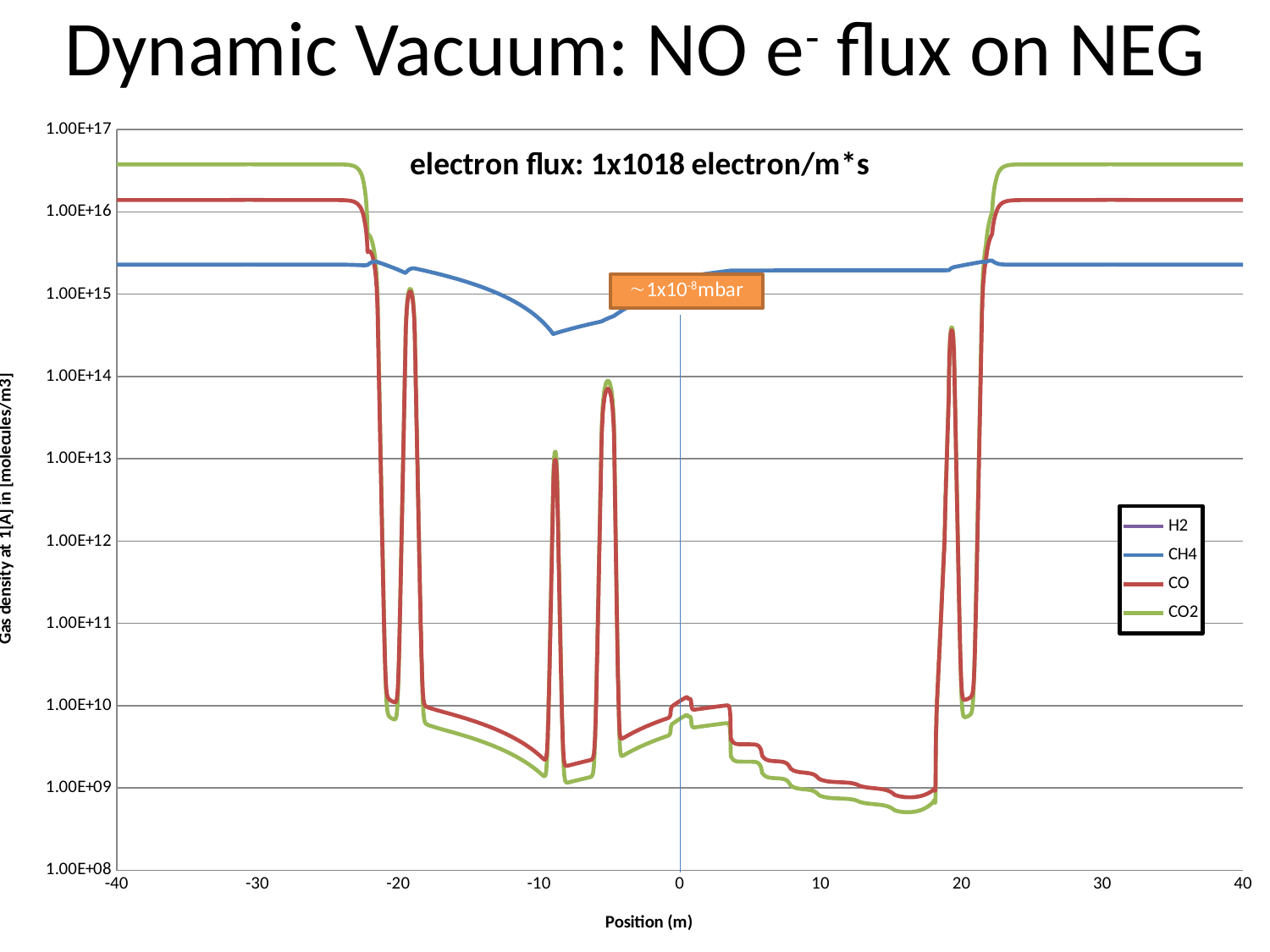
Is the CH4 value at position -40 greater or less than 1.00E+16? less At position 0, which series has the higher value, CH4 or CO? CH4 Is the CO2 value at position -40 greater or less than 1.00E+16? greater What kind of chart is shown on the slide? line chart Is the CO2 value at position 15 greater or less than 1.00E+09? less What is the title of the chart? electron flux: 1x1018 electron/m*s At position -40, which series has the higher value, CO2 or CH4? CO2 How many series does the legend list? 4 What is the label of the x axis? Position (m) Does the CH4 series rise or fall as position goes from -20 to -10? fall